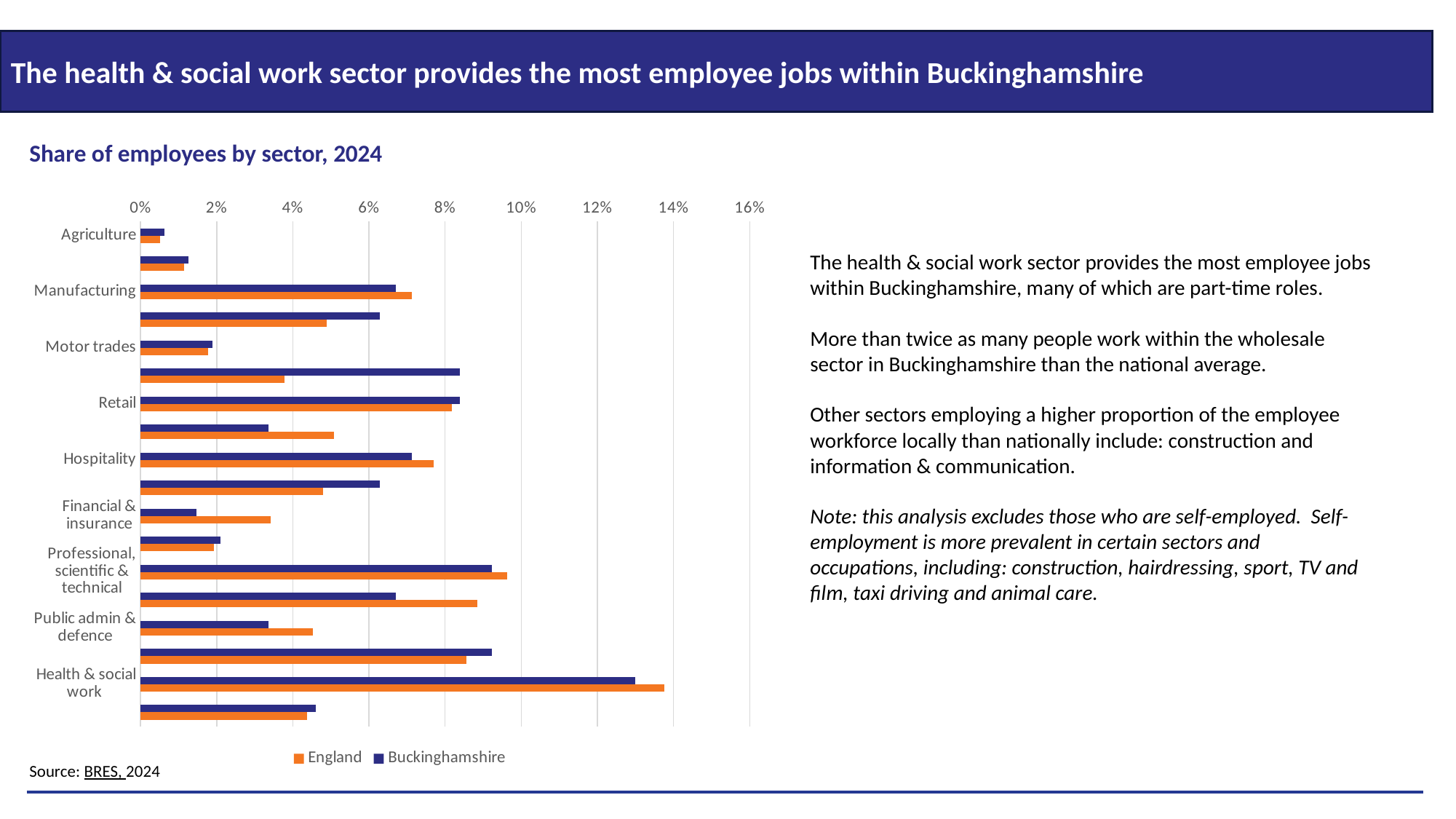
For Public admin & defence, which is larger: the England value or the Buckinghamshire value? England Is the Buckinghamshire value for Agriculture greater or less than 2%? less Is the Buckinghamshire value for Health & social work greater or less than 12%? greater How many series does the chart's legend list? 2 Is the England value for Professional, scientific & technical greater or less than 8%? greater For Financial & insurance, which is larger: the England value or the Buckinghamshire value? England Which sector has the lowest share of employees for England? Agriculture Which colour represents England in the chart? Orange What is the title of the chart? Share of employees by sector, 2024 What kind of chart is shown on the slide? Bar chart Which sector has the highest share of employees for Buckinghamshire? Health & social work